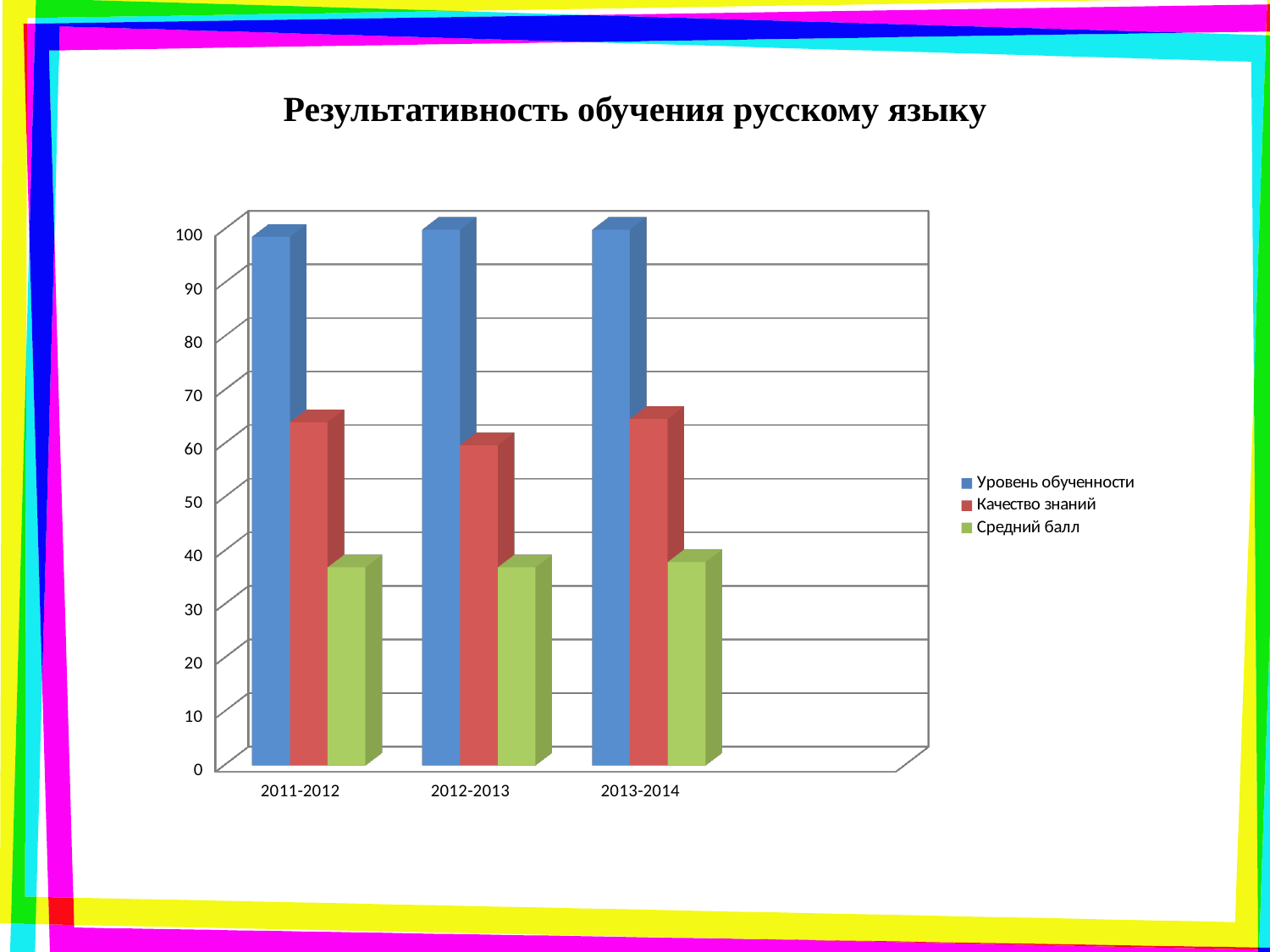
How many academic years are shown on the x axis? 3 Is the value of Средний балл for 2011-2012 greater or less than 50? less Which series is shown in green? Средний балл Is the value of Качество знаний for 2013-2014 greater or less than 50? greater Is the value of Качество знаний for 2012-2013 greater or less than 70? less Which year has the lowest value for Качество знаний? 2012-2013 Which series has the lowest value in 2012-2013? Средний балл How many series does the legend list? 3 Which is larger in 2013-2014: Уровень обученности or Качество знаний? Уровень обученности What kind of chart is shown on the slide? bar chart What is the title of the chart? Результативность обучения русскому языку